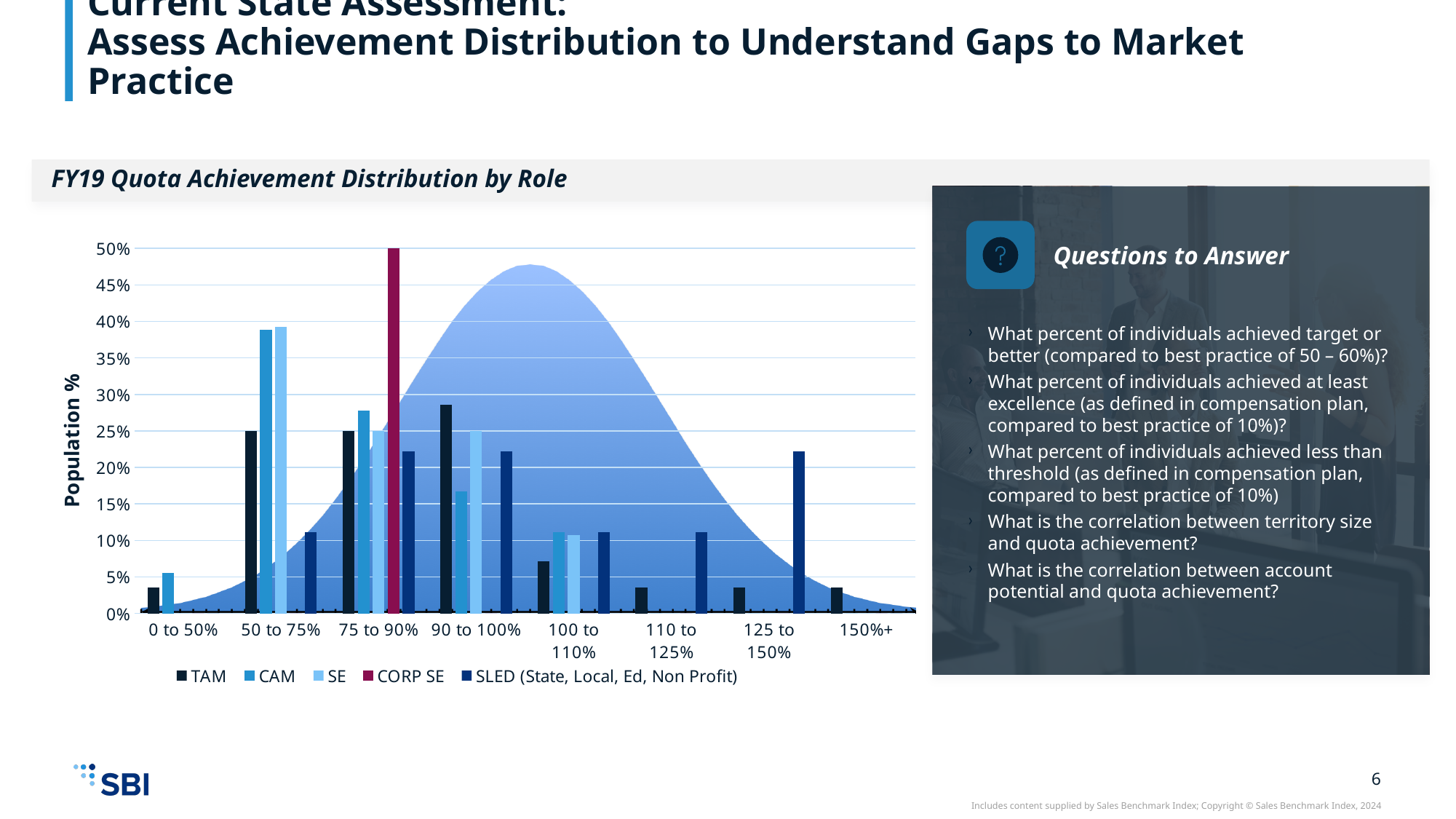
What is the label of the vertical axis? Population % Is the value for TAM in the 0 to 50% category greater or less than 5%? less In the 90 to 100% category, which is larger: the TAM bar or the CAM bar? TAM Is the value for SLED in the 125 to 150% category greater or less than 20%? greater Is the value for CAM in the 50 to 75% category greater or less than 35%? greater What is the title of the chart? FY19 Quota Achievement Distribution by Role How many achievement categories are shown on the x axis? 8 How many series does the legend list? 5 Which series has the tallest bar in the whole chart? CORP SE What kind of chart is used to show the quota achievement distribution by role? bar chart